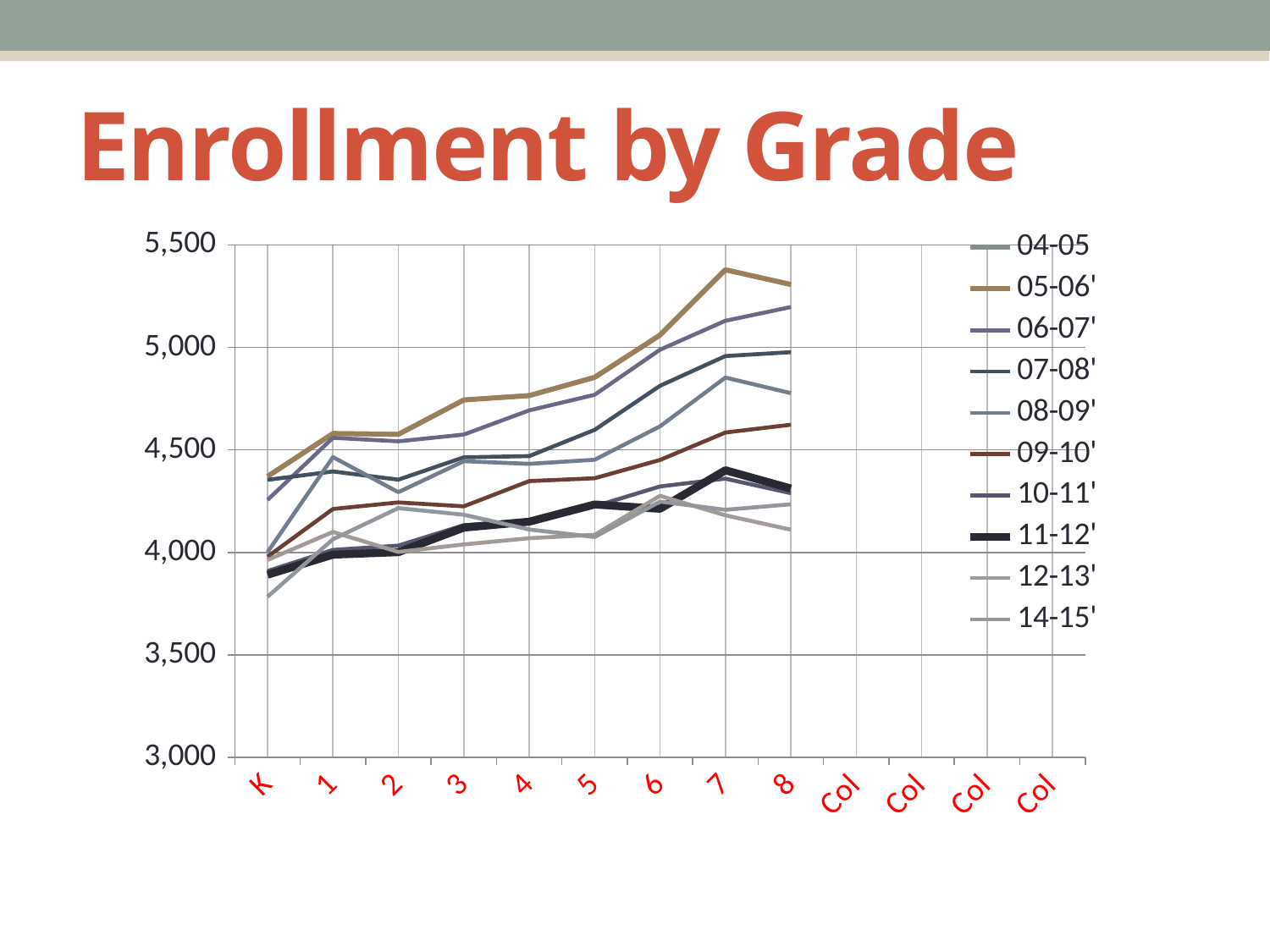
How many series does the legend list? 10 Is the value for 09-10' at grade 8 greater or less than 4,500? greater Is the value for 05-06' at grade 7 greater or less than 5,000? greater How many categories are shown along the x axis? 13 Is the value for 08-09' at grade 8 greater or less than 5,000? less What kind of chart is shown on the slide? line chart Which series has the lowest value at K? 14-15' What is the title of the chart? Enrollment by Grade At grade 8, which is larger: the value for 05-06' or the value for 12-13'? 05-06' Does the 05-06' series generally rise or fall from K to grade 7? rise